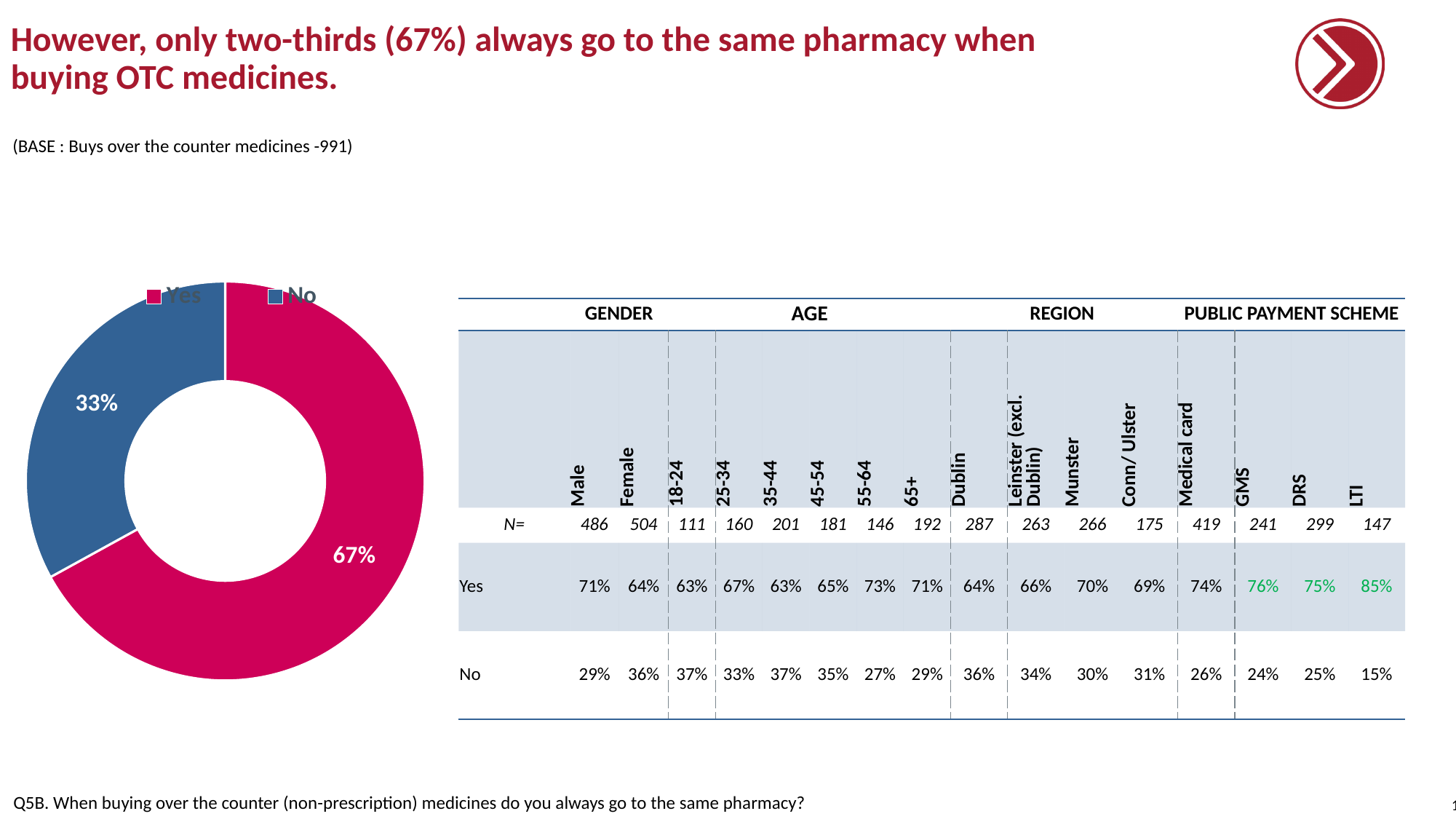
What colour is the No slice in the donut chart? Blue Which slice of the donut chart is the largest? Yes What colour is the Yes slice in the donut chart? Red/pink What type of chart is shown on the left of the slide? Donut (pie) chart What percentage of respondents answered Yes in the donut chart? 67% How many entries does the legend of the donut chart list? 2 Which is larger in the donut chart, the Yes slice or the No slice? Yes What is the difference in percentage points between the Yes and No slices of the donut chart? 34 How many slices does the donut chart have? 2 What percentage of respondents answered No in the donut chart? 33% Which slice of the donut chart is the smallest? No What share of the donut chart does the No slice represent? 33%